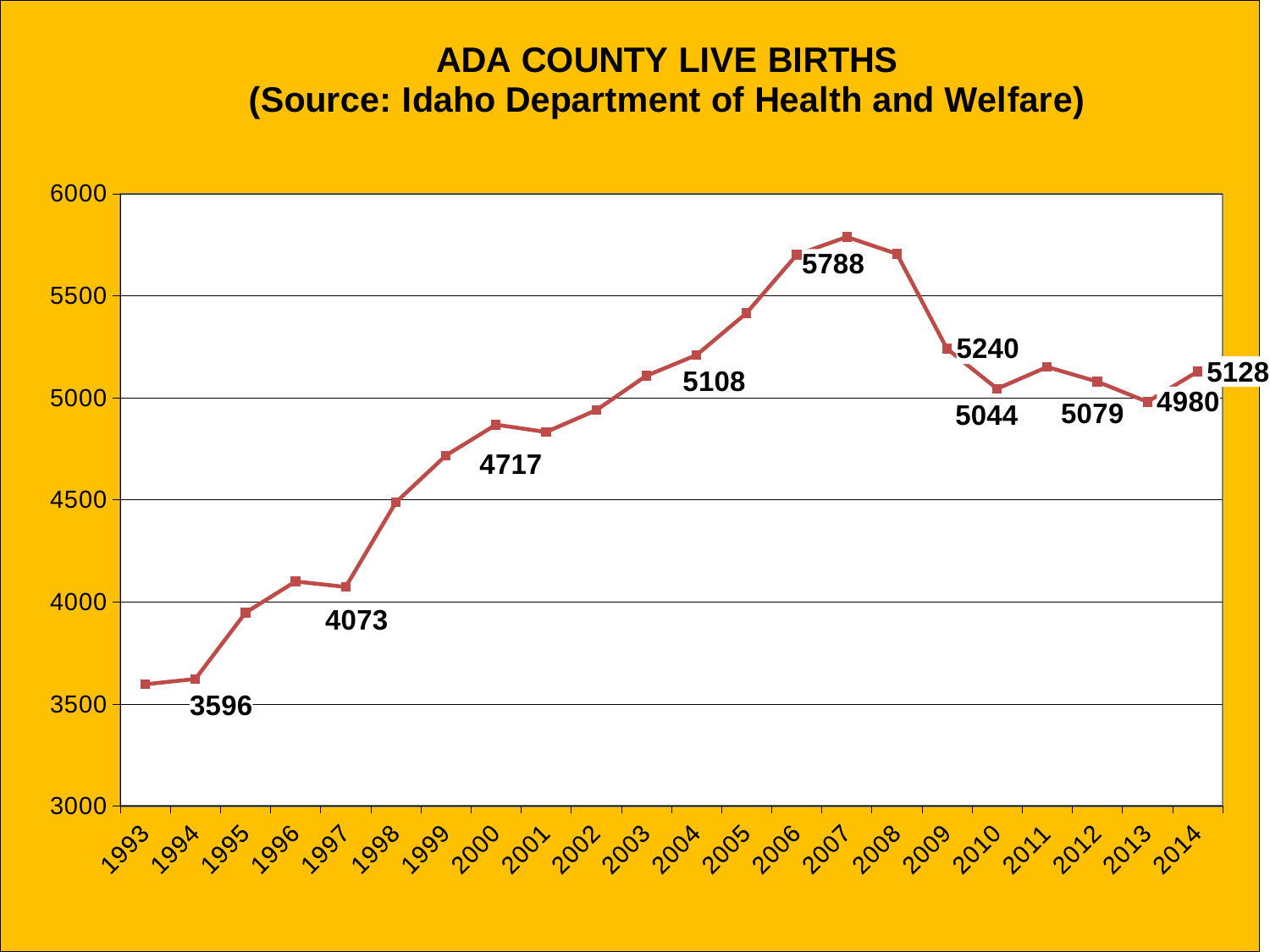
What value is shown for 2014? 5128 What kind of chart is shown on the slide? Line chart Is the value for 2005 greater or less than 5000? greater What value is shown for 2013? 4980 Is the value for 1995 greater or less than 4000? less What is the difference between the live births in 2007 and 2009? 548 What was the number of Ada County live births in 2007? 5788 How many years are plotted on the x axis? 22 Which year has the highest number of live births? 2007 What was the number of Ada County live births in 1993? 3596 Which year has the lowest number of live births? 1993 Which year had more live births, 2012 or 2013? 2012